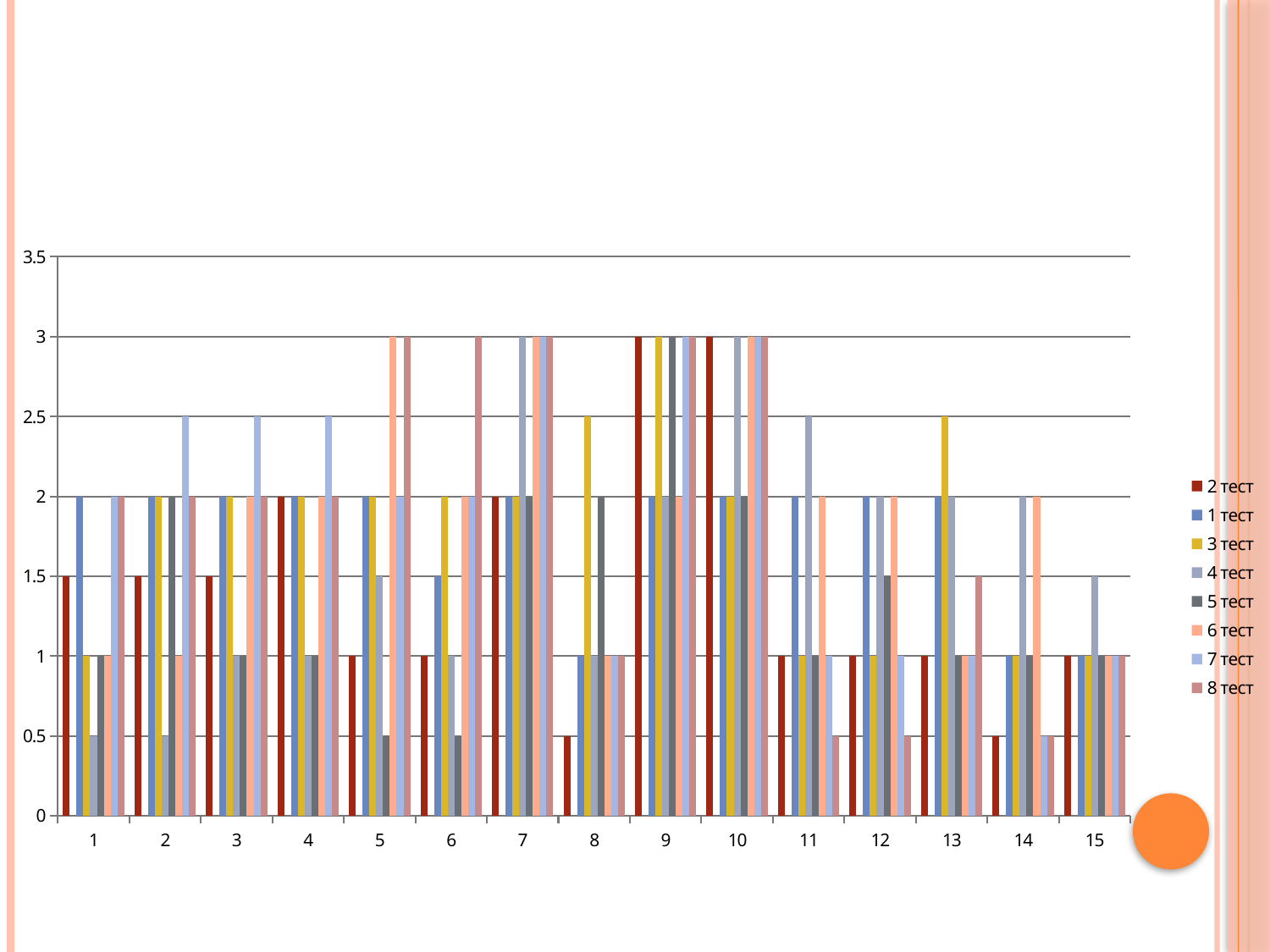
What is the value of 2 тест for category 1? 1.5 Which series has the highest value in category 13? 3 тест What is the highest value shown on the y axis? 3.5 What is the value of 7 тест for category 2? 2.5 Is the value of 2 тест for category 8 greater or less than 1? less How many categories are shown along the x axis? 15 What is the value of 3 тест for category 13? 2.5 Is the value of 3 тест for category 13 greater or less than 2? greater In category 8, which is larger: 3 тест or 2 тест? 3 тест How many series does the legend list? 8 Which series has the lowest value in category 1? 4 тест What kind of chart is shown on the slide? bar chart